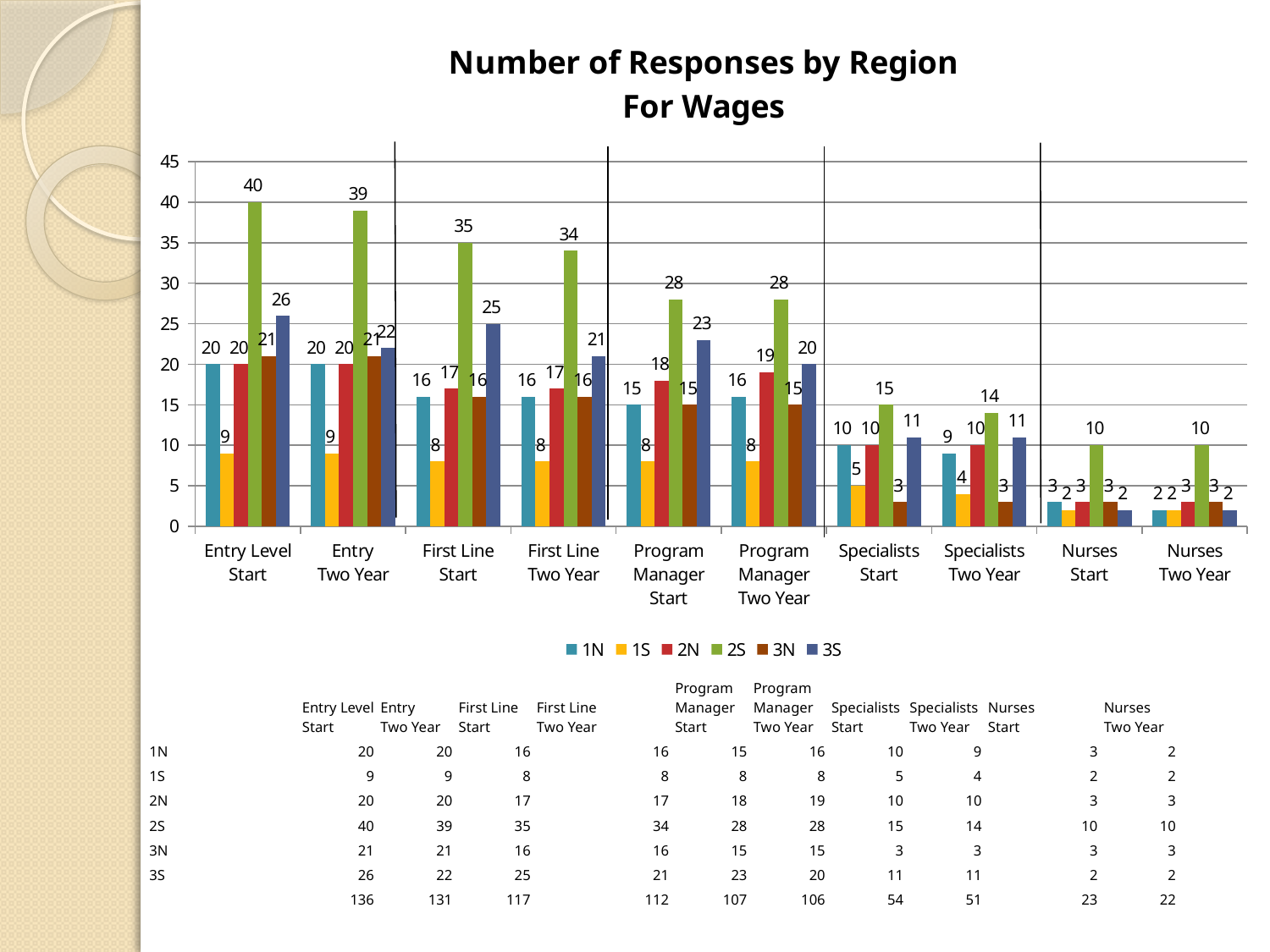
What is the value of the 2S series for Entry Level Start? 40 What is the value of the 3N series for Specialists Start? 3 Do the 2S values generally rise or fall moving from Entry Level Start to Nurses Two Year? Fall What kind of chart is shown on the slide? Bar chart Which is larger: the 3S value for Entry Level Start or the 3S value for Entry Two Year? Entry Level Start What is the difference between the 2S value for Entry Level Start and the 2S value for Entry Two Year? 1 How many categories are shown on the x axis of the chart? 10 Which category has the highest value for the 2S series? Entry Level Start What is the title of the chart? Number of Responses by Region For Wages What is the value of the 1S series for First Line Start? 8 How many series does the legend list? 6 Which category has the lowest value for the 1N series? Nurses Two Year